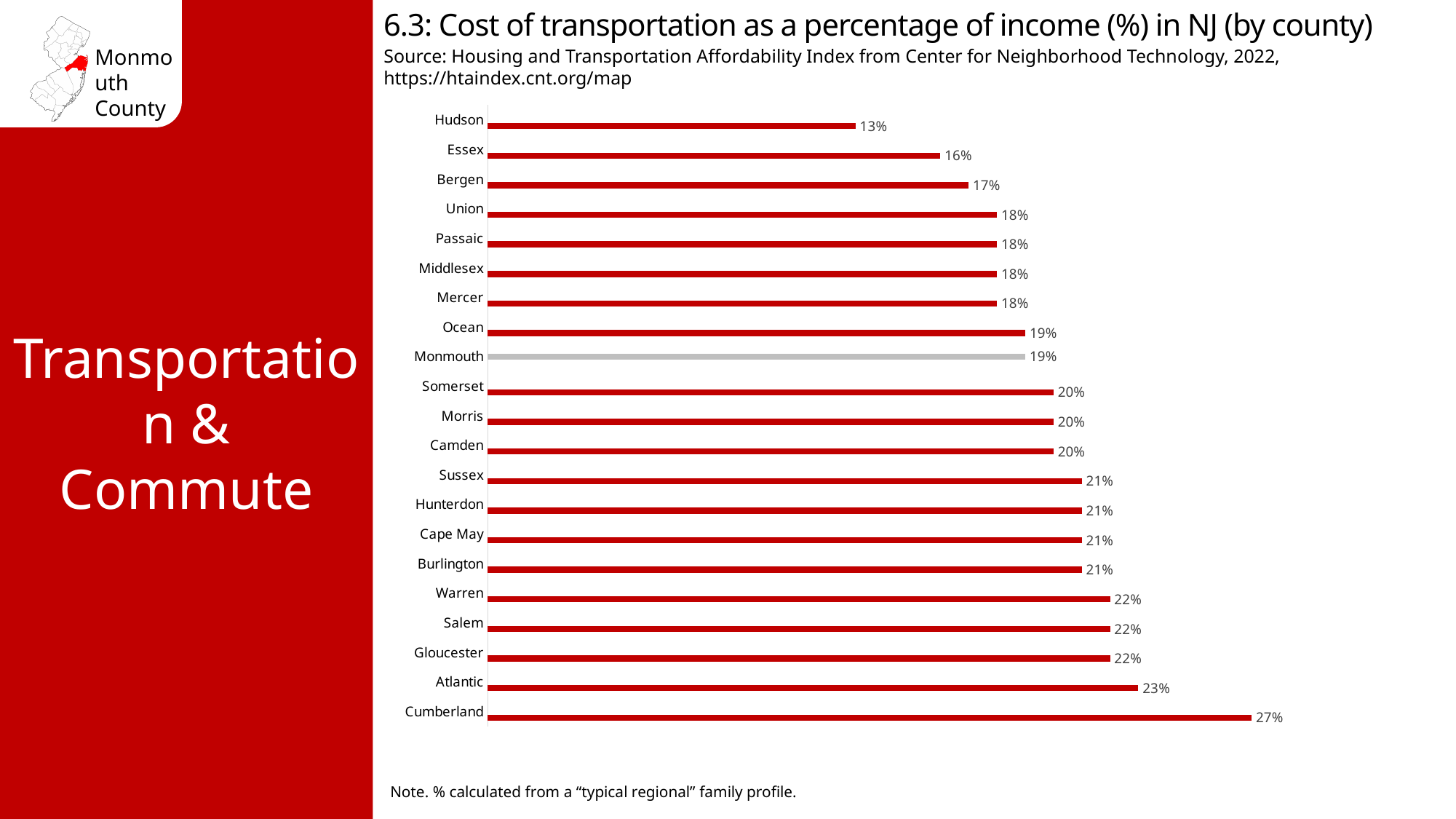
What is the value shown for Hudson County? 13% Which county's bar is shown in grey instead of red? Monmouth Which has a higher value, Essex or Bergen? Bergen What is the value shown for Cumberland County? 27% What is the difference between the values for Cumberland and Hudson? 14% What type of chart is shown on the slide? Bar chart Which county has the highest cost of transportation as a percentage of income? Cumberland What is the cost of transportation as a percentage of income for Monmouth County? 19% What is the difference between the values for Atlantic and Monmouth? 4% Which county has the lowest cost of transportation as a percentage of income? Hudson What is the value shown for Atlantic County? 23% How many counties are shown in the chart? 21